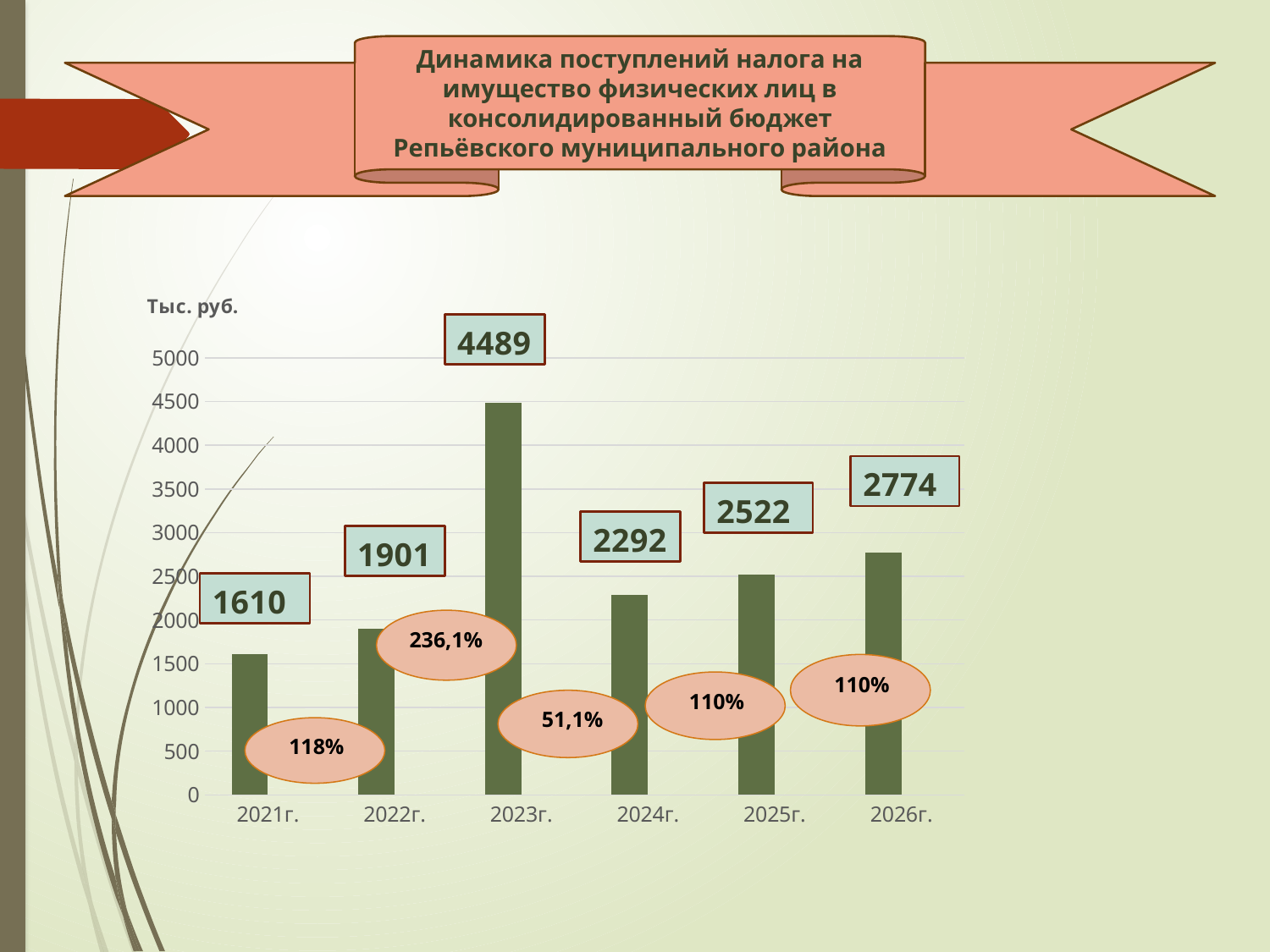
Is the value for 2023г. greater or less than 4000? greater What percentage is shown in the oval label between 2022г. and 2023г.? 236,1% Which year has the lowest value? 2021г. Which year has the highest value? 2023г. What is the value for 2023г.? 4489 Which is larger, the value for 2024г. or the value for 2025г.? 2025г. What is the difference between the values for 2026г. and 2025г.? 252 What kind of chart is shown on the slide? bar chart What is the value for 2026г.? 2774 How many years are shown on the x axis? 6 What is the value for 2021г.? 1610 What is the difference between the values for 2023г. and 2022г.? 2588